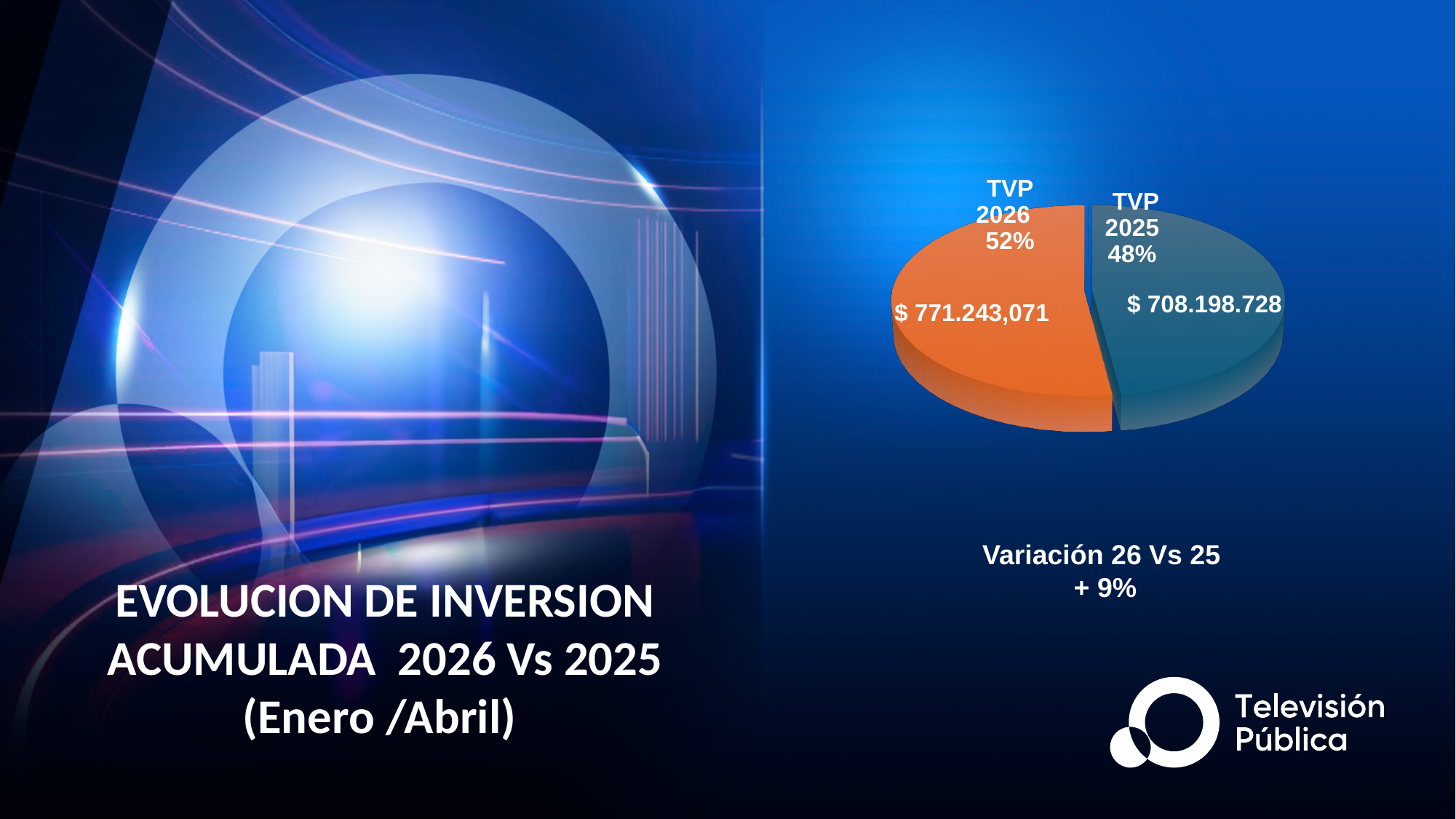
What share of the pie does TVP 2025 represent? 48% What value is shown for TVP 2026 in the pie chart? $ 771.243,071 What kind of chart is shown on the slide? pie chart How many slices does the pie chart have? 2 What share of the pie does TVP 2026 represent? 52% What variation between 2026 and 2025 is stated below the pie chart? + 9% Which slice of the pie chart is the largest? TVP 2026 What value is shown for TVP 2025 in the pie chart? $ 708.198.728 What colour is the TVP 2026 slice of the pie chart? orange Which is larger, the value for TVP 2026 or TVP 2025? TVP 2026 Which slice of the pie chart is the smallest? TVP 2025